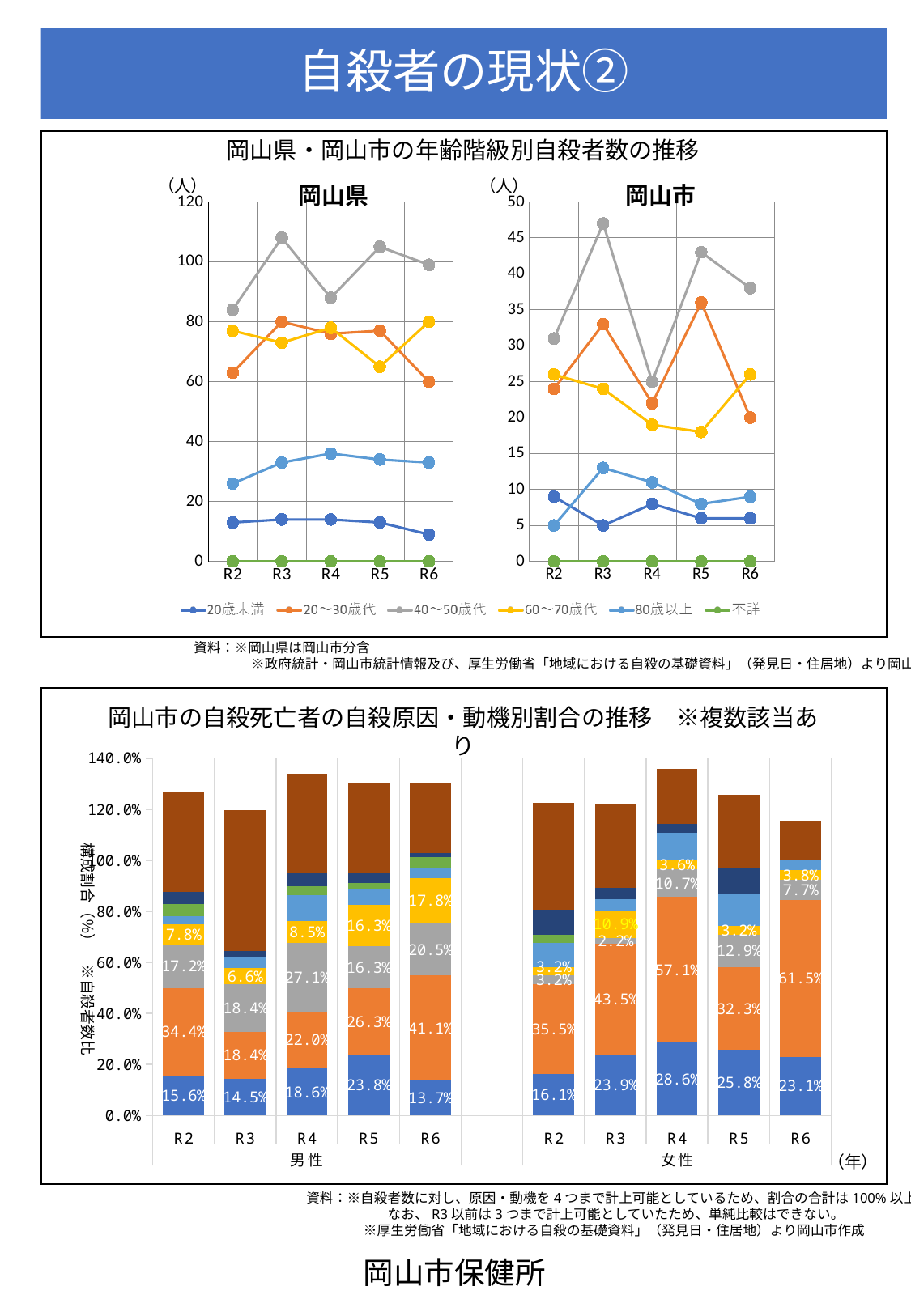
How many years are plotted on the x axis of the 岡山市 line chart? 5 In the 岡山市の自殺死亡者の自殺原因・動機別割合の推移 chart, what is the value printed on the bottom (blue) segment of the 男性 R5 bar? 23.8% What kind of chart is the 岡山市の自殺死亡者の自殺原因・動機別割合の推移 chart? bar chart In the 岡山県 line chart, is the value for 40〜50歳代 at R3 greater or less than 100? greater In the 岡山市の自殺死亡者の自殺原因・動機別割合の推移 chart, what is the difference between the orange segment of the 女性 R6 bar (61.5%) and the orange segment of the 女性 R4 bar (57.1%)? 4.4% What kind of chart is the 岡山県 chart? line chart In the 岡山市の自殺死亡者の自殺原因・動機別割合の推移 chart, which 男性 year has the highest value on its bottom (blue) segment? R5 In the 岡山県 line chart, does the 20〜30歳代 line rise or fall from R5 to R6? fall How many series does the legend under the 岡山県 and 岡山市 charts list? 6 In the 岡山市 line chart at R6, which is larger: 60〜70歳代 or 20〜30歳代? 60〜70歳代 In the 岡山市 line chart, is the value for 20〜30歳代 at R5 greater or less than 30? greater In the 岡山市 line chart, which year has the highest value for 40〜50歳代? R3